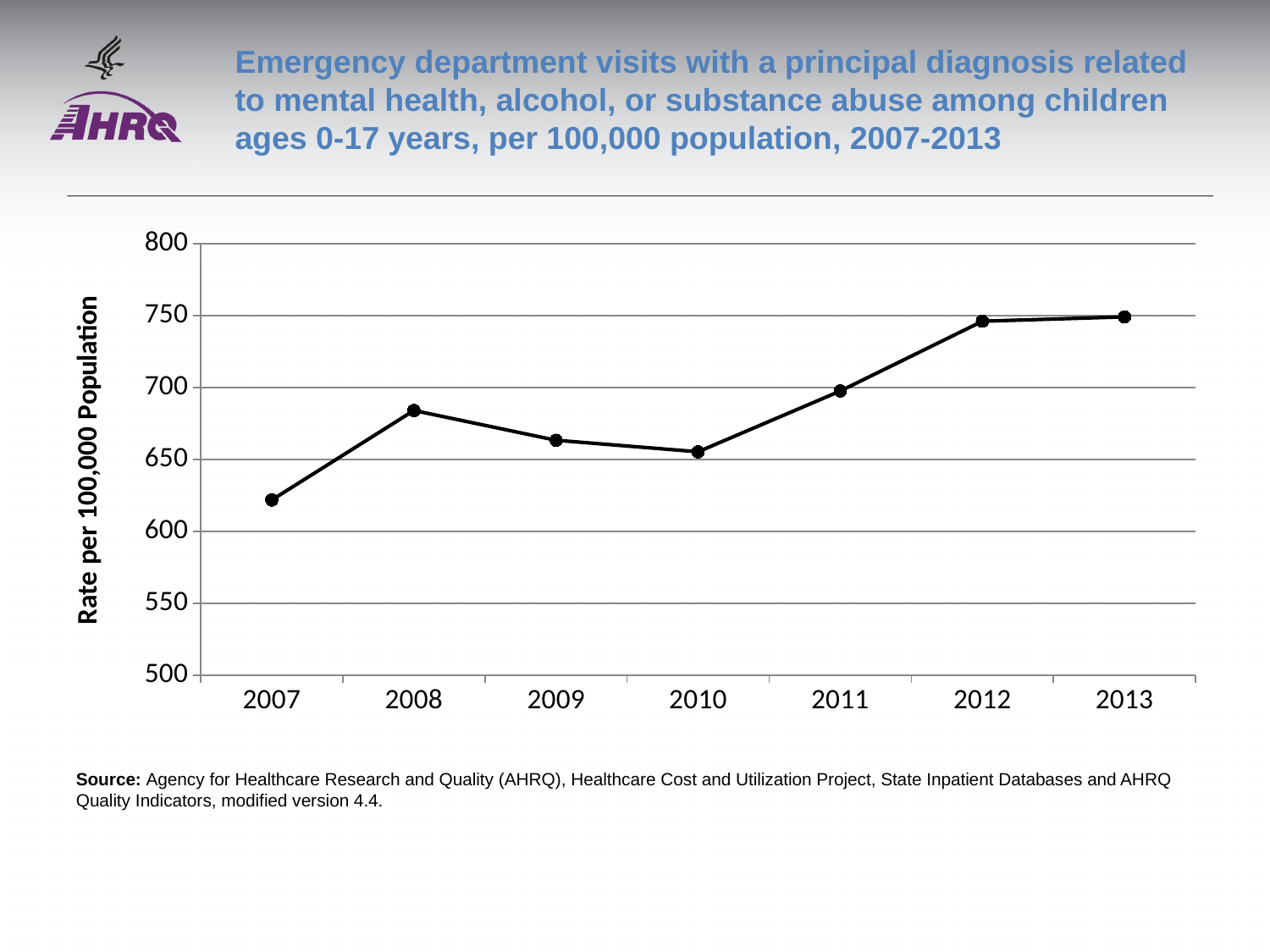
Is the value for 2009 greater or less than 700? less How many years (data points) are plotted on the chart? 7 Is the value for 2008 greater or less than 650? greater Which year has the lowest rate on the chart? 2007 Which year has the higher rate, 2007 or 2011? 2011 Is the value for 2007 greater or less than 650? less Do the values rise or fall from 2010 to 2012? rise Which year has the higher rate, 2008 or 2009? 2008 What kind of chart is shown on the slide? line chart What is the label on the vertical axis of the chart? Rate per 100,000 Population